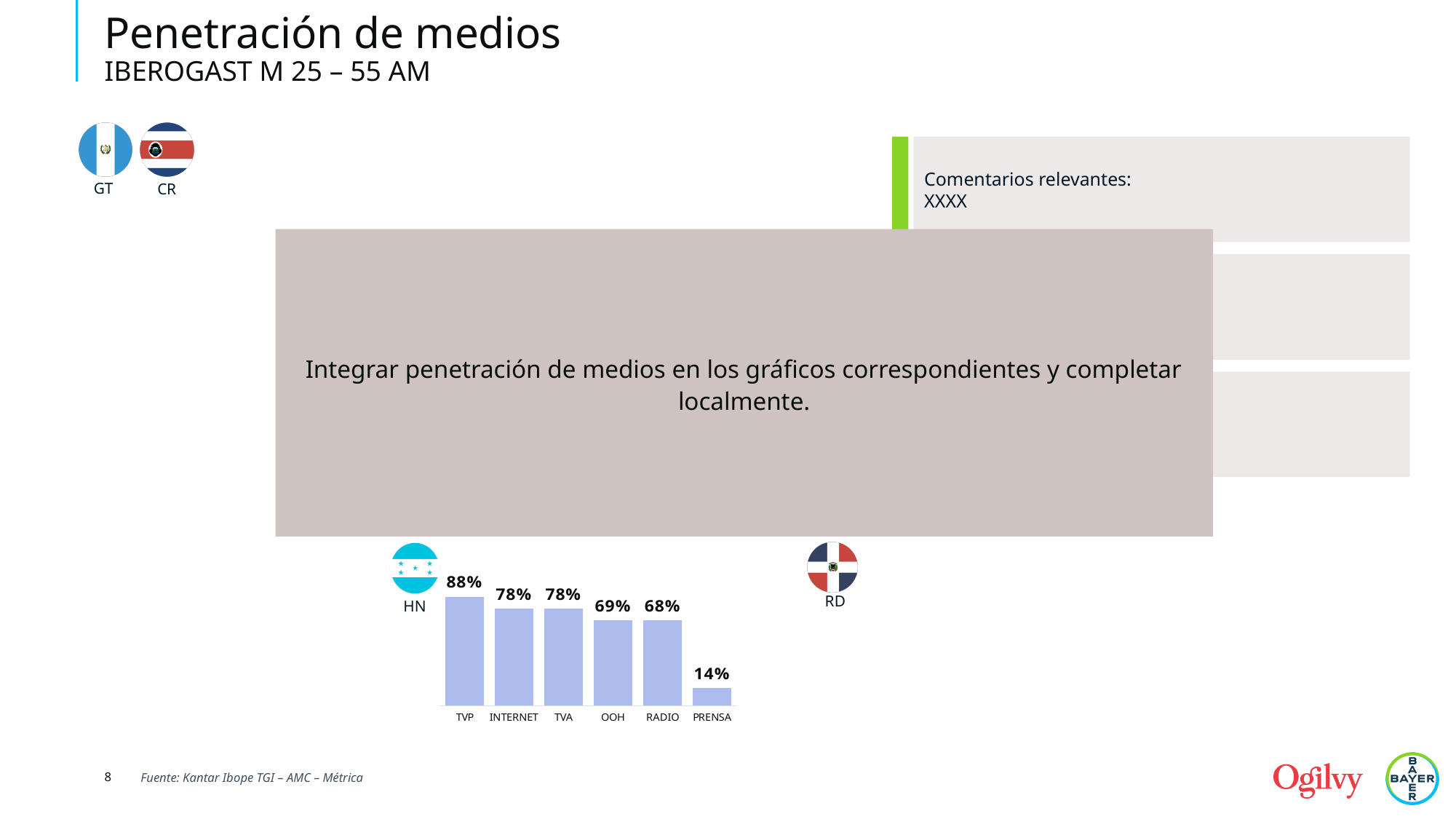
In the HN bar chart, what is the difference between the values for TVP and PRENSA? 74% In the HN bar chart, what is the value for OOH? 69% What kind of chart is shown next to the HN flag? bar chart In the HN bar chart, which category has the lowest value? PRENSA In the HN bar chart, which category has the highest value? TVP In the HN bar chart, what is the difference between the values for TVA and OOH? 9% In the HN bar chart, what is the value for PRENSA? 14% How many categories are shown in the HN bar chart? 6 In the HN bar chart, what is the value for INTERNET? 78% In the HN bar chart, which is larger, the value for TVP or the value for RADIO? TVP In the HN bar chart, what is the value for RADIO? 68% In the HN bar chart, what is the value for TVP? 88%